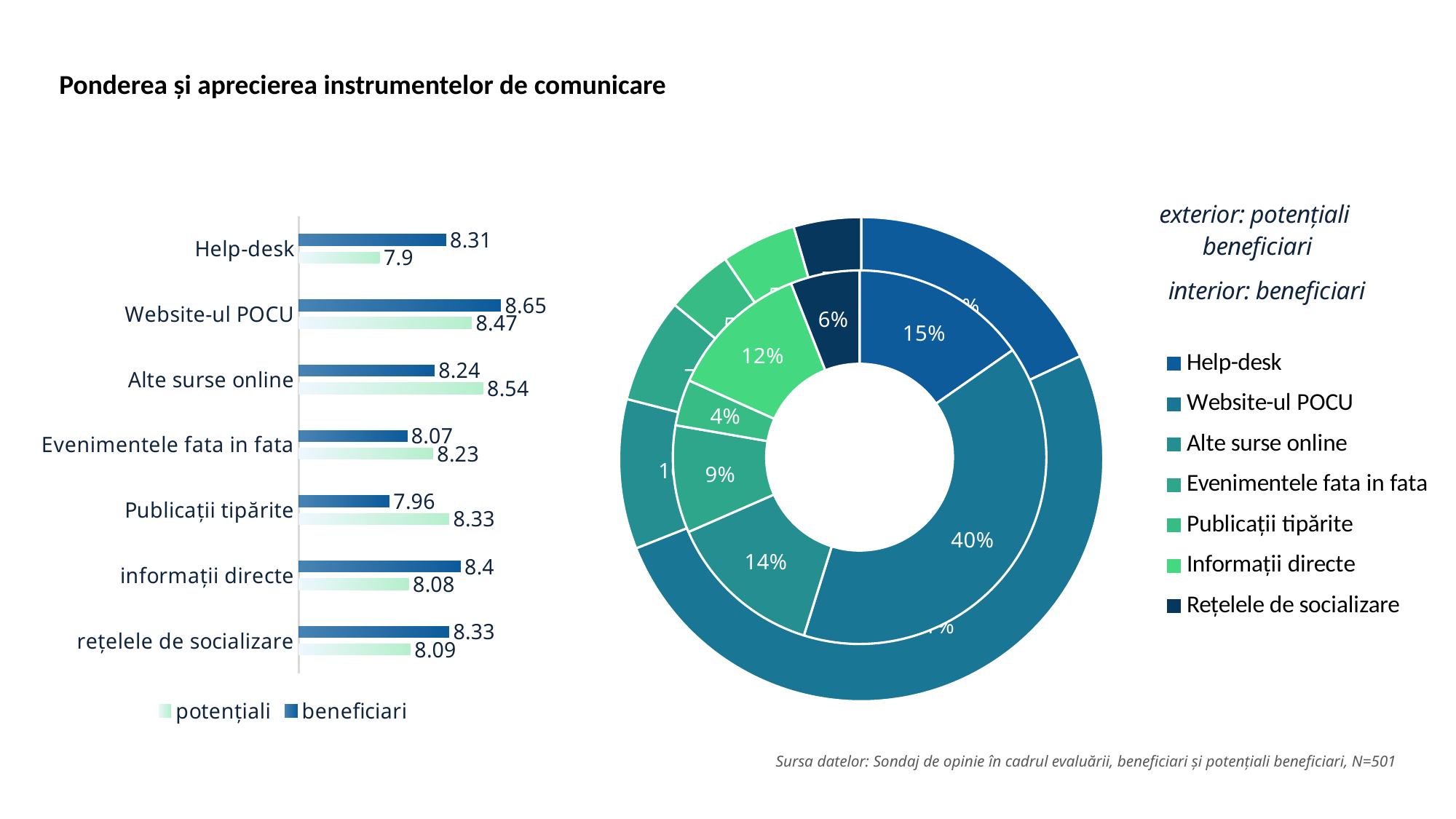
What kind of chart is on the right side of the slide? doughnut chart In the bar chart on the left, what is the difference between the beneficiari and potențiali values for Publicații tipărite? 0.37 How many series does the legend of the bar chart on the left list? 2 In the bar chart on the left, which category has the lowest potențiali value? Help-desk How many categories does the bar chart on the left show? 7 In the bar chart on the left, which is larger for informații directe: the potențiali value or the beneficiari value? beneficiari In the bar chart on the left, what is the potențiali value for Help-desk? 7.9 In the bar chart on the left, what is the beneficiari value for Website-ul POCU? 8.65 In the doughnut chart on the right, what is the inner-ring (beneficiari) share for Rețelele de socializare? 6% In the bar chart on the left, which category has the highest beneficiari value? Website-ul POCU In the doughnut chart on the right, what is the inner-ring (beneficiari) share for Website-ul POCU? 40% In the bar chart on the left, what is the potențiali value for Alte surse online? 8.54